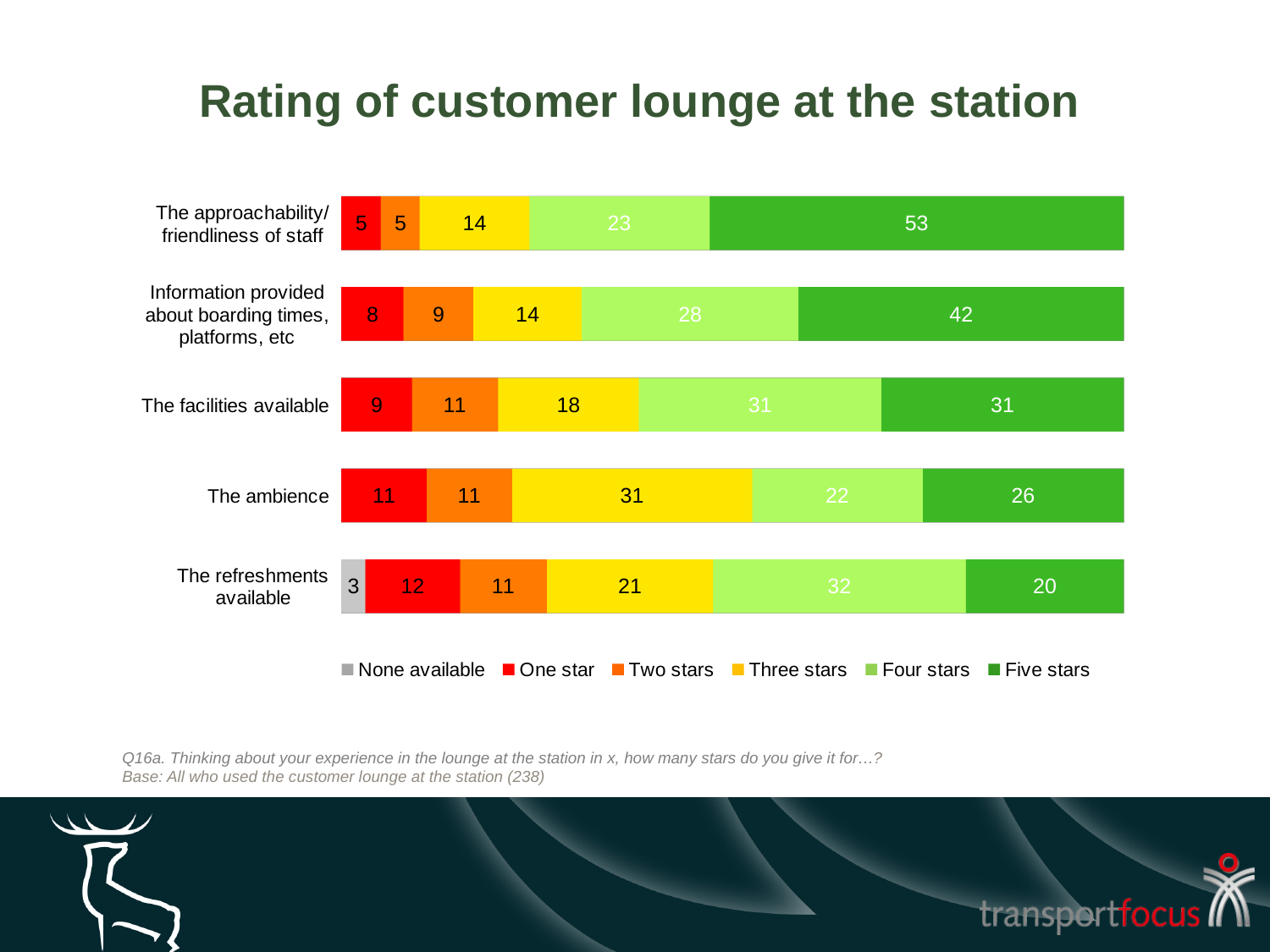
How many categories are shown on the chart? 5 What is the title of the chart? Rating of customer lounge at the station What kind of chart is shown on the slide? Stacked bar chart What is the Two stars value for 'Information provided about boarding times, platforms, etc'? 9 Which category has the highest Five stars value? The approachability/ friendliness of staff What is the difference between the Four stars value for 'The facilities available' and the Four stars value for 'The approachability/ friendliness of staff'? 8 What is the Three stars value for 'The ambience'? 31 What is the Five stars value for 'The approachability/ friendliness of staff'? 53 Which category has the lowest Five stars value? The refreshments available How many series does the legend list? 6 What is the 'None available' value for 'The refreshments available'? 3 Which has the larger Three stars value: 'The ambience' or 'The refreshments available'? The ambience